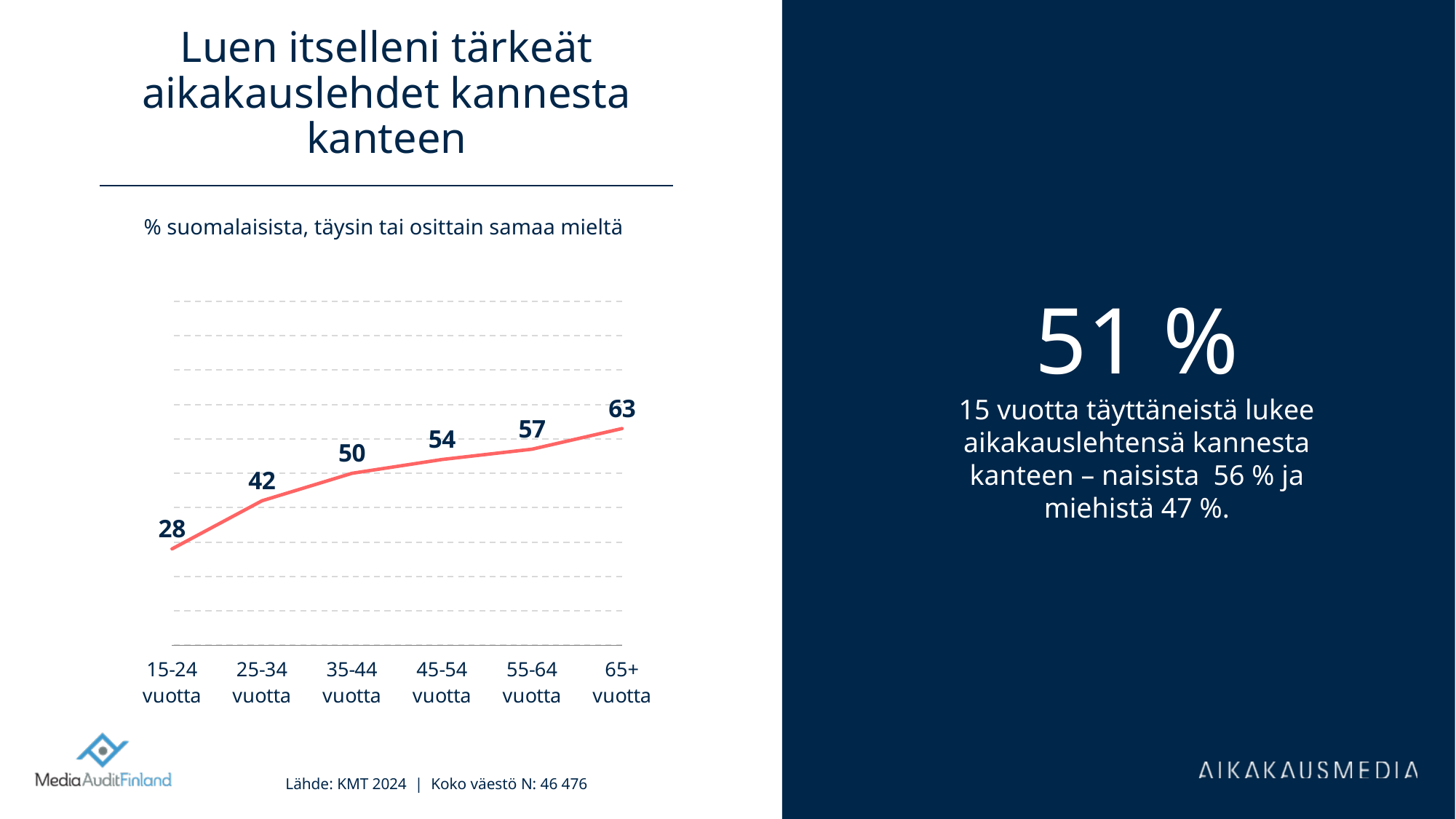
Which is larger, the value for 55-64 vuotta or the value for 45-54 vuotta? 55-64 vuotta What is the value for the 45-54 vuotta age group? 54 What is the title of the chart? Luen itselleni tärkeät aikakauslehdet kannesta kanteen What is the value for the 15-24 vuotta age group? 28 What is the value for the 65+ vuotta age group? 63 What is the difference between the values for 65+ vuotta and 15-24 vuotta? 35 How many age groups are plotted on the chart? 6 Which age group has the lowest value? 15-24 vuotta Do the values rise or fall as age increases along the x axis? rise Which age group has the highest value? 65+ vuotta What kind of chart is shown on the slide? line chart What is the difference between the values for 35-44 vuotta and 25-34 vuotta? 8